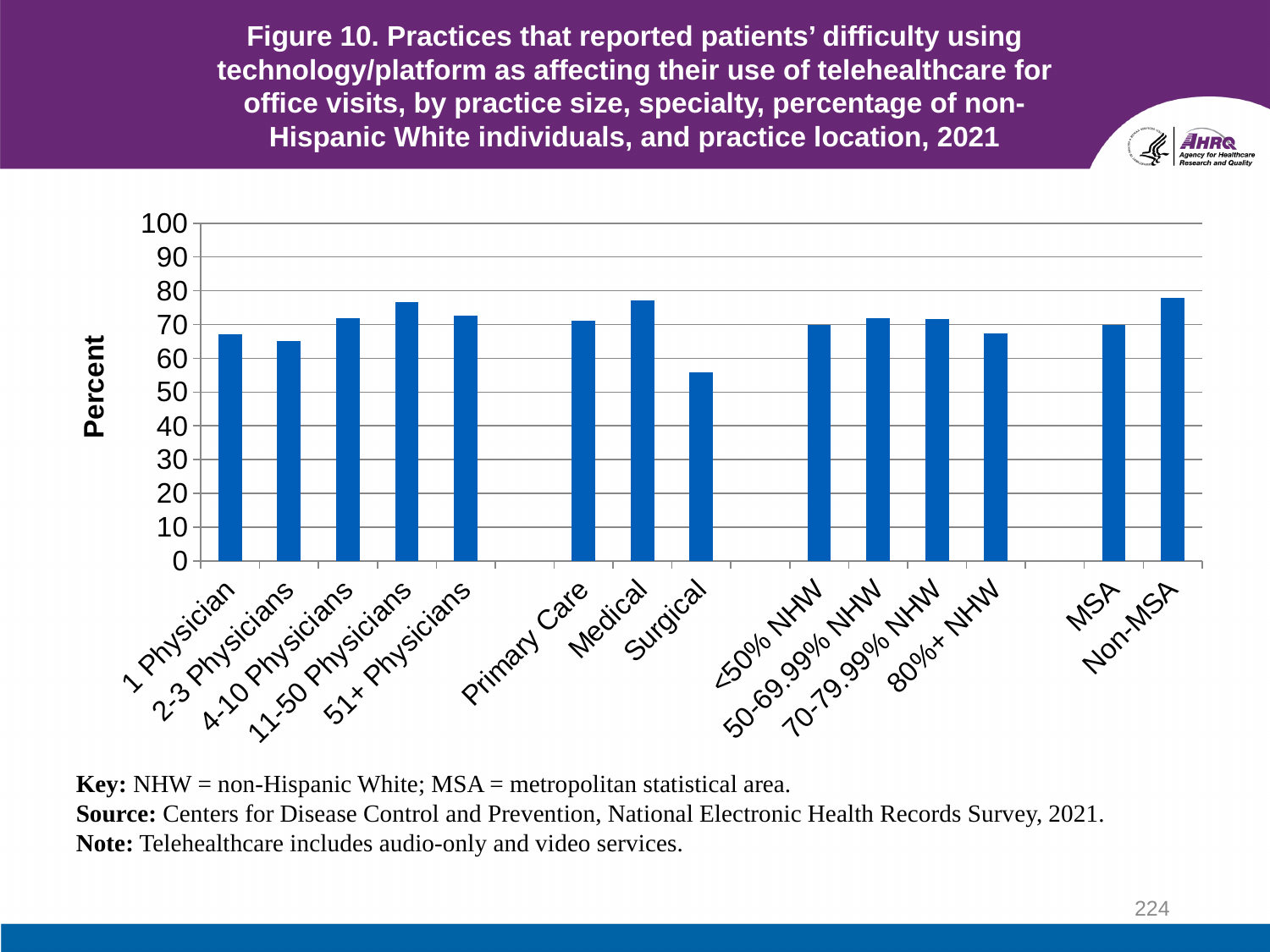
Which category has the lowest value in the chart? Surgical Which is larger, the value for Surgical or the value for Primary Care? Primary Care Is the value for Medical greater or less than 70? greater What is the label on the vertical axis of the chart? Percent Is the value for Surgical greater or less than 60? less How many categories (bars) are plotted in the chart? 14 Is the value for Non-MSA greater or less than 70? greater What kind of chart is shown on the slide? Bar chart Which is larger, the value for Medical or the value for Surgical? Medical Which is larger, the value for 2-3 Physicians or the value for 4-10 Physicians? 4-10 Physicians